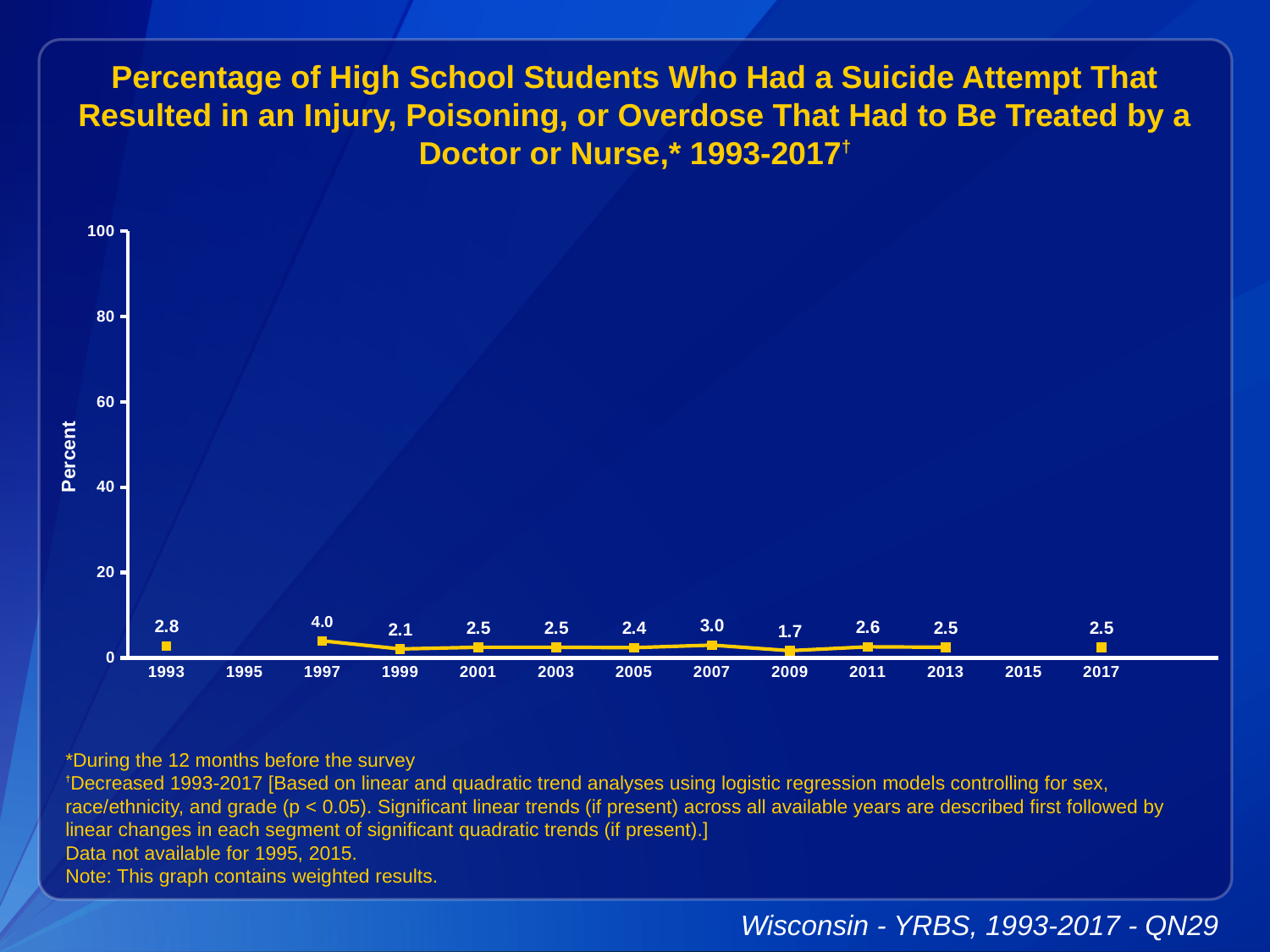
Which year has the larger value, 2007 or 2011? 2007 What was the percentage of high school students who had a suicide attempt requiring medical treatment in 1993? 2.8 Which year has the lowest value on the chart? 2009 Is the value for 1997 greater or less than 20? less What is the difference between the values for 1993 and 2017? 0.3 What is the label on the vertical axis? Percent Which year has the highest value on the chart? 1997 What is the difference between the values for 1997 and 2009? 2.3 What value is shown for 2009? 1.7 What kind of chart is shown on the slide? line chart What value is shown for 2017? 2.5 How many years have a plotted data point on the chart? 11